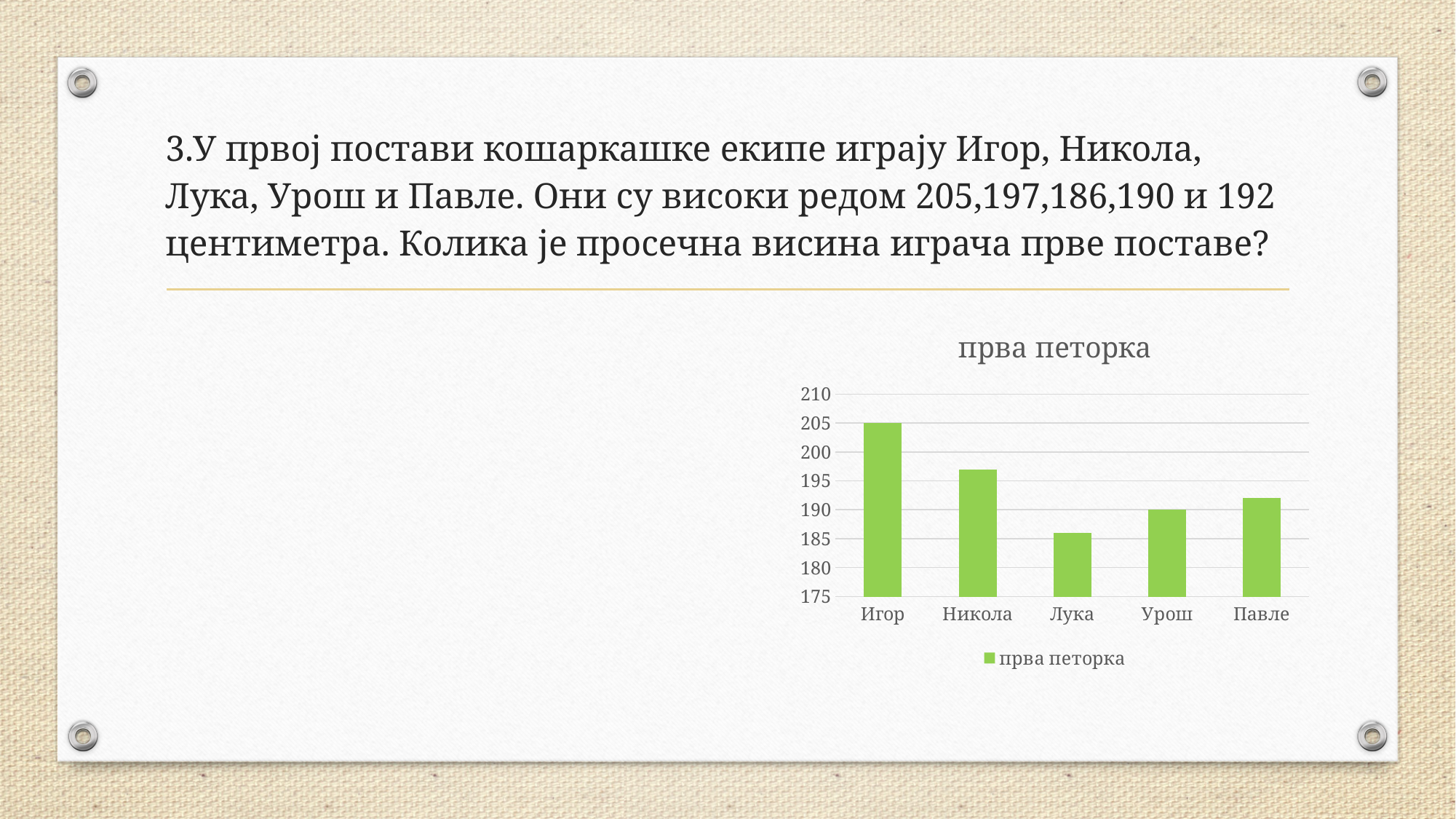
What is the value for Игор? 205 How many series does the legend list? 1 What is the value for Урош? 190 Which category has the lowest value? Лука What is the title of the chart? прва петорка Is the value for Лука greater or less than 190? less What kind of chart is shown? bar chart Which is larger, the value for Никола or the value for Павле? Никола Which category has the highest value? Игор How many categories are shown on the x axis? 5 What is the difference between the values for Игор and Урош? 15 Is the value for Никола greater or less than 200? less